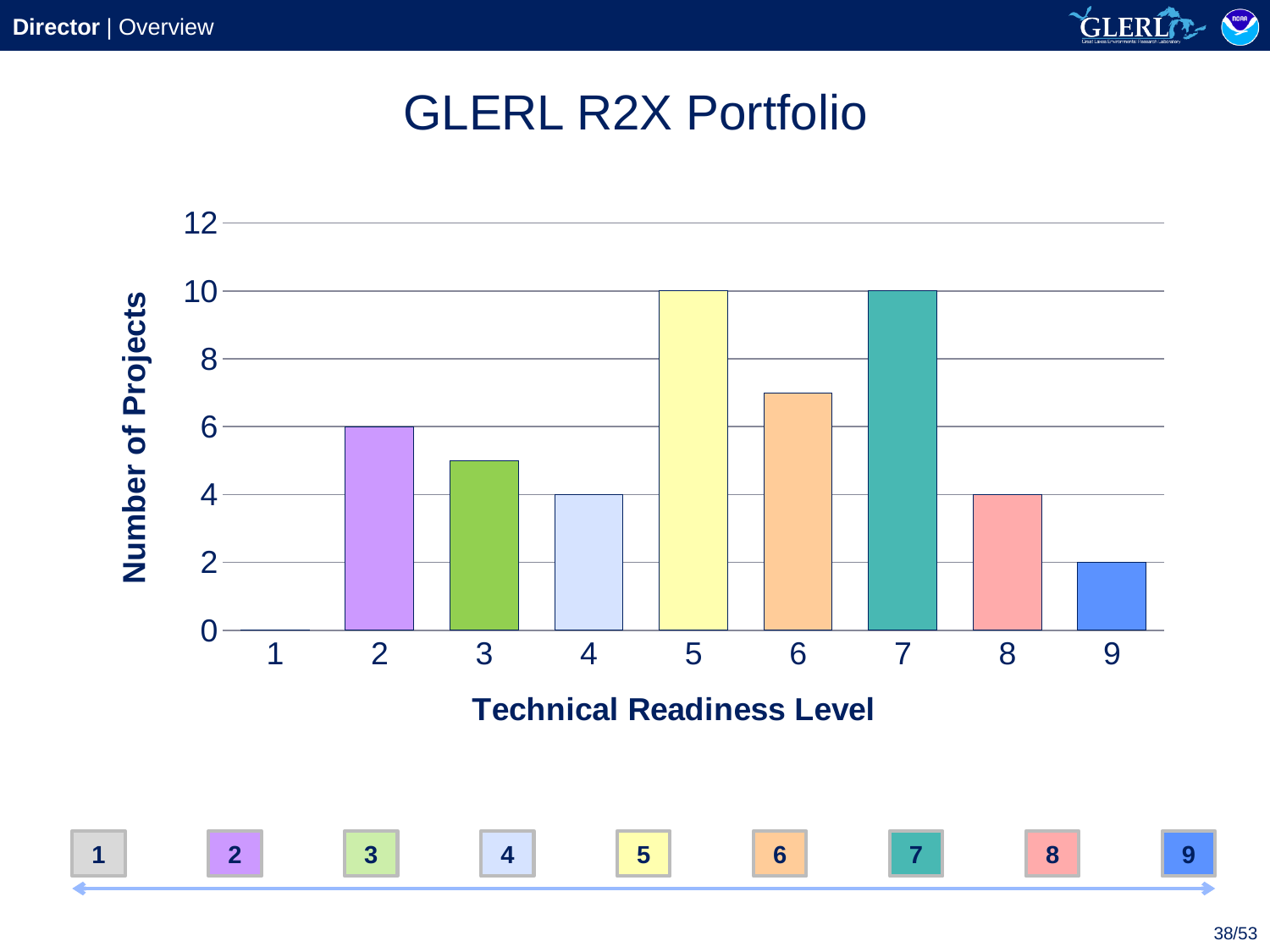
What kind of chart is shown on the slide? bar chart Which has more projects, Technical Readiness Level 2 or Level 8? Level 2 How many projects are at Technical Readiness Level 9? 2 Is the number of projects at Technical Readiness Level 6 greater or less than 6? greater What is the title of the y axis? Number of Projects Which Technical Readiness Level has the fewest projects? 1 How many Technical Readiness Level categories are plotted on the x axis? 9 Is the number of projects at Technical Readiness Level 3 greater or less than 6? less How many projects are at Technical Readiness Level 4? 4 How many projects are at Technical Readiness Level 2? 6 How many projects are at Technical Readiness Level 5? 10 What is the difference between the number of projects at Technical Readiness Level 7 and Level 9? 8